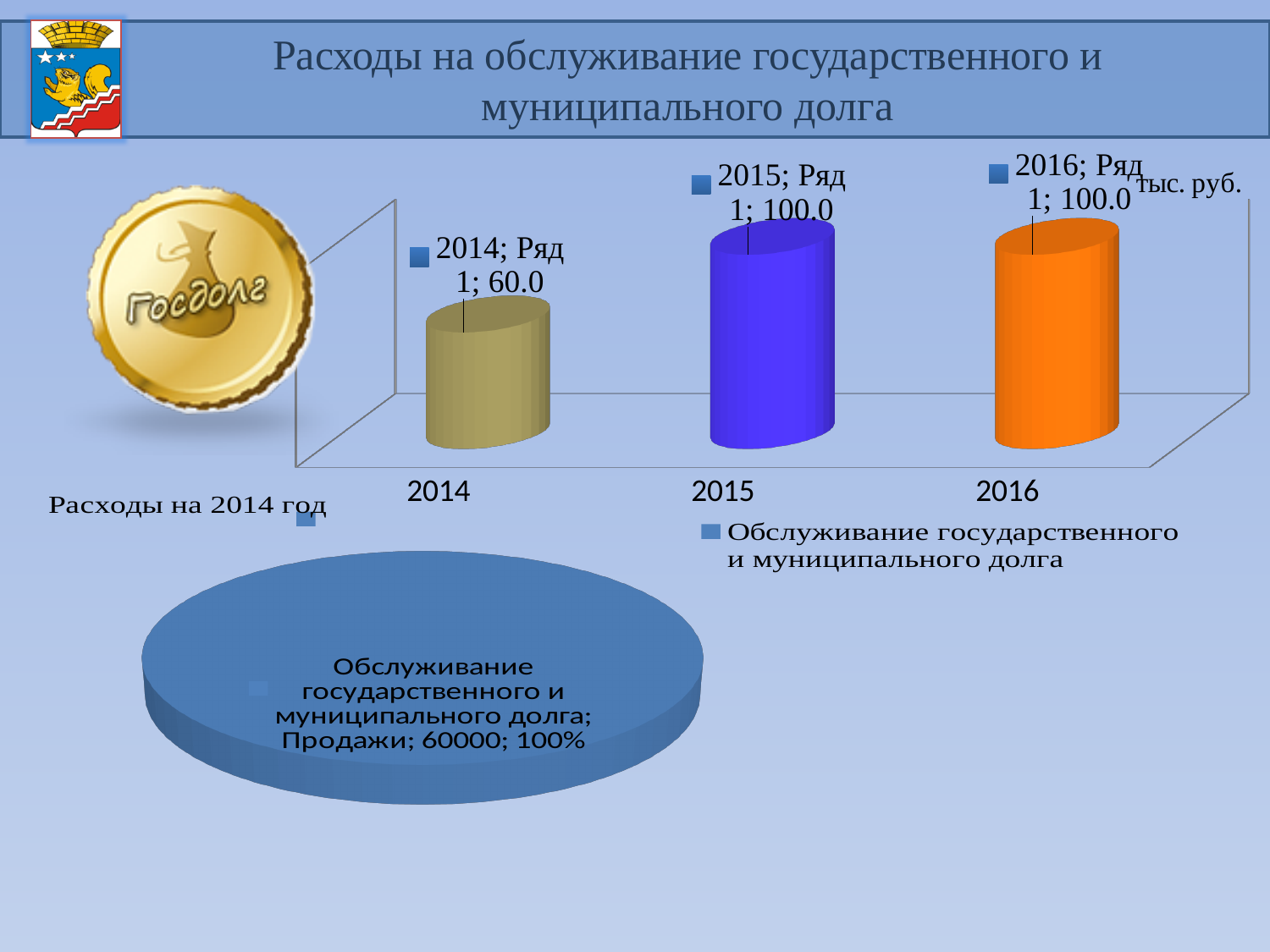
What kind of chart is the upper chart with the years 2014, 2015 and 2016? bar chart In the bar chart, what is the value for 2014? 60.0 What unit is shown in the top right corner of the bar chart? тыс. руб. How many years are shown on the x axis of the bar chart? 3 In the bar chart, what is the difference between the values for 2015 and 2014? 40.0 In the bar chart, what is the value for 2015? 100.0 In the pie chart 'Расходы на 2014 год', what share does the slice 'Обслуживание государственного и муниципального долга' have? 100% In the pie chart 'Расходы на 2014 год', what value is printed for 'Обслуживание государственного и муниципального долга'? 60000 In the bar chart, do the values rise or fall from 2014 to 2015? rise In the bar chart, what is the value for 2016? 100.0 In the bar chart, which is larger, the value for 2014 or the value for 2016? 2016 In the bar chart, which year has the lowest value? 2014